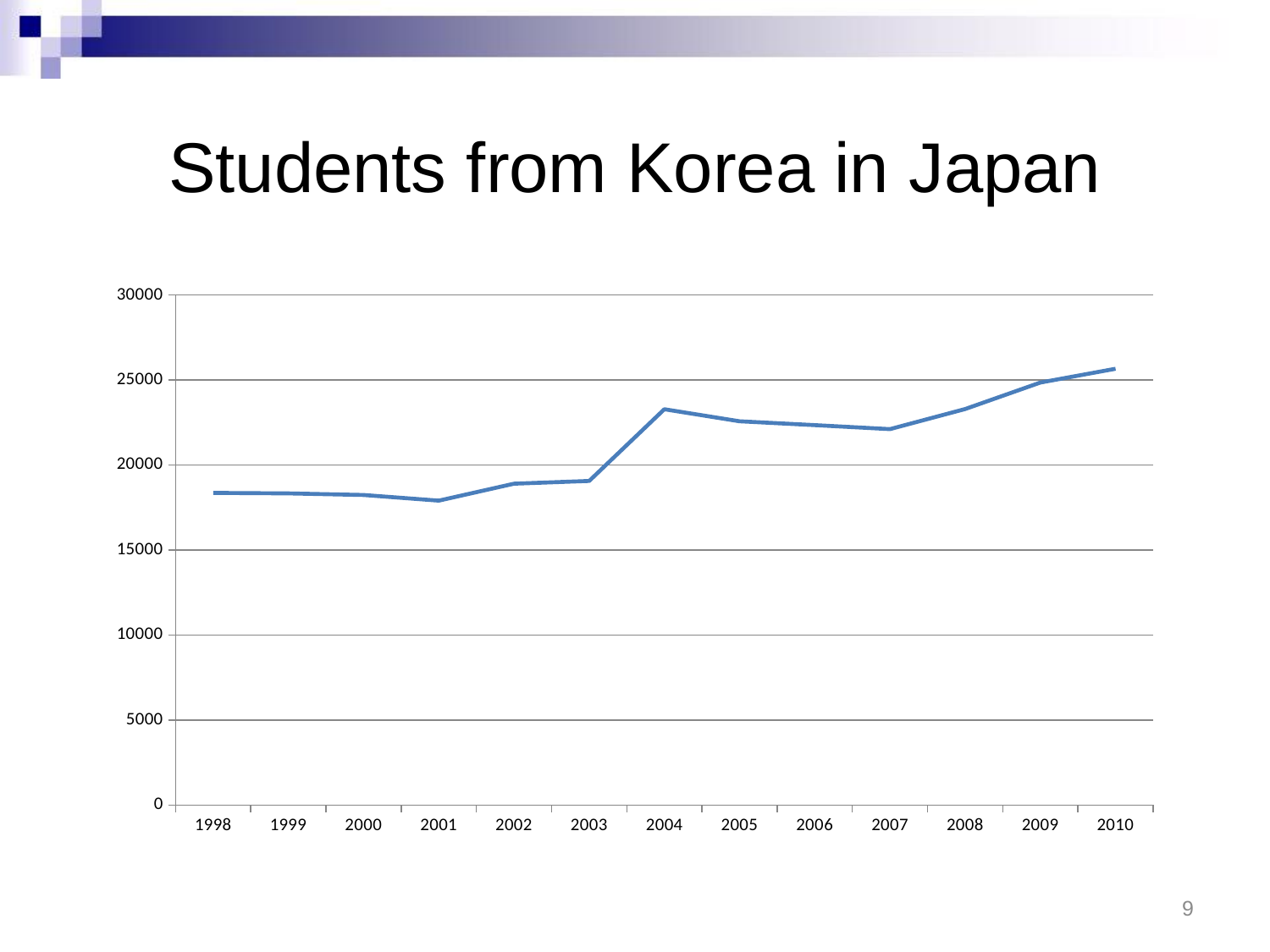
Is the value for 2004 greater or less than 20000? greater Which year has the larger value, 2003 or 2004? 2004 Is the value for 2008 greater or less than 25000? less What kind of chart is shown on the slide? line chart Which year has the larger value, 1998 or 2010? 2010 Which year has the lowest number of students from Korea in Japan? 2001 Overall, do the values rise or fall from 1998 to 2010? rise How many years are plotted on the x axis of the chart? 13 Is the value for 2010 greater or less than 25000? greater What is the title of the slide containing the chart? Students from Korea in Japan Which year has the highest number of students from Korea in Japan? 2010